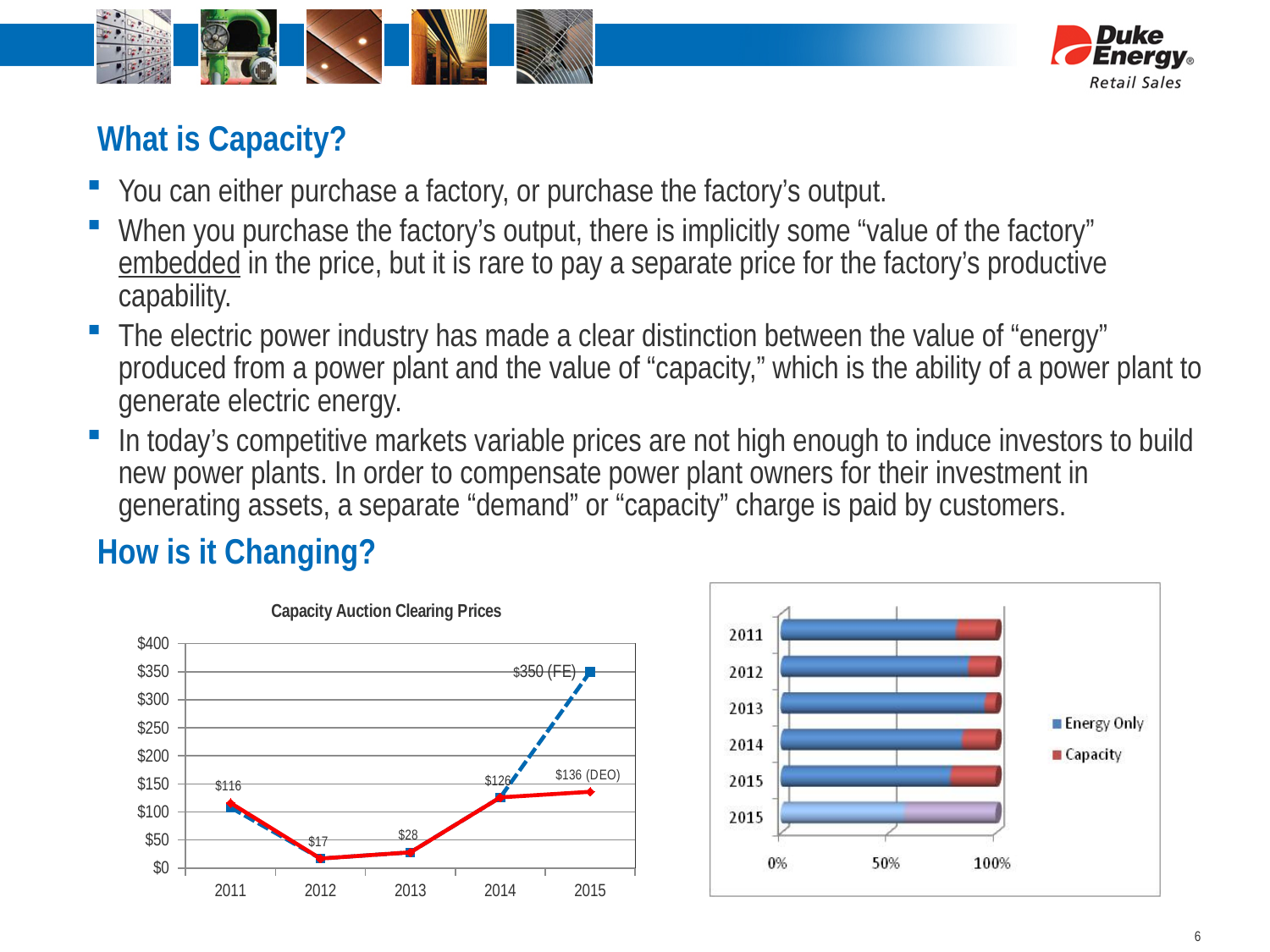
In the chart on the right of the slide, how many bars are plotted? 6 In the Capacity Auction Clearing Prices chart, what is the value labeled for 2013? $28 In the chart on the right of the slide, how many series does the legend list? 2 What kind of chart is the chart on the right of the slide? bar chart In the Capacity Auction Clearing Prices chart, what is the value labeled for 2011? $116 What kind of chart is the Capacity Auction Clearing Prices chart? line chart In the Capacity Auction Clearing Prices chart, which year has the lowest clearing price? 2012 What is the title of the chart on the left of the slide? Capacity Auction Clearing Prices In the Capacity Auction Clearing Prices chart, what is the value labeled for 2012? $17 In the Capacity Auction Clearing Prices chart, how many years are shown on the x axis? 5 In the chart on the right of the slide, is the Energy Only share for 2013 greater or less than 50%? greater In the Capacity Auction Clearing Prices chart, what is the difference between the 2013 value and the 2012 value? $11